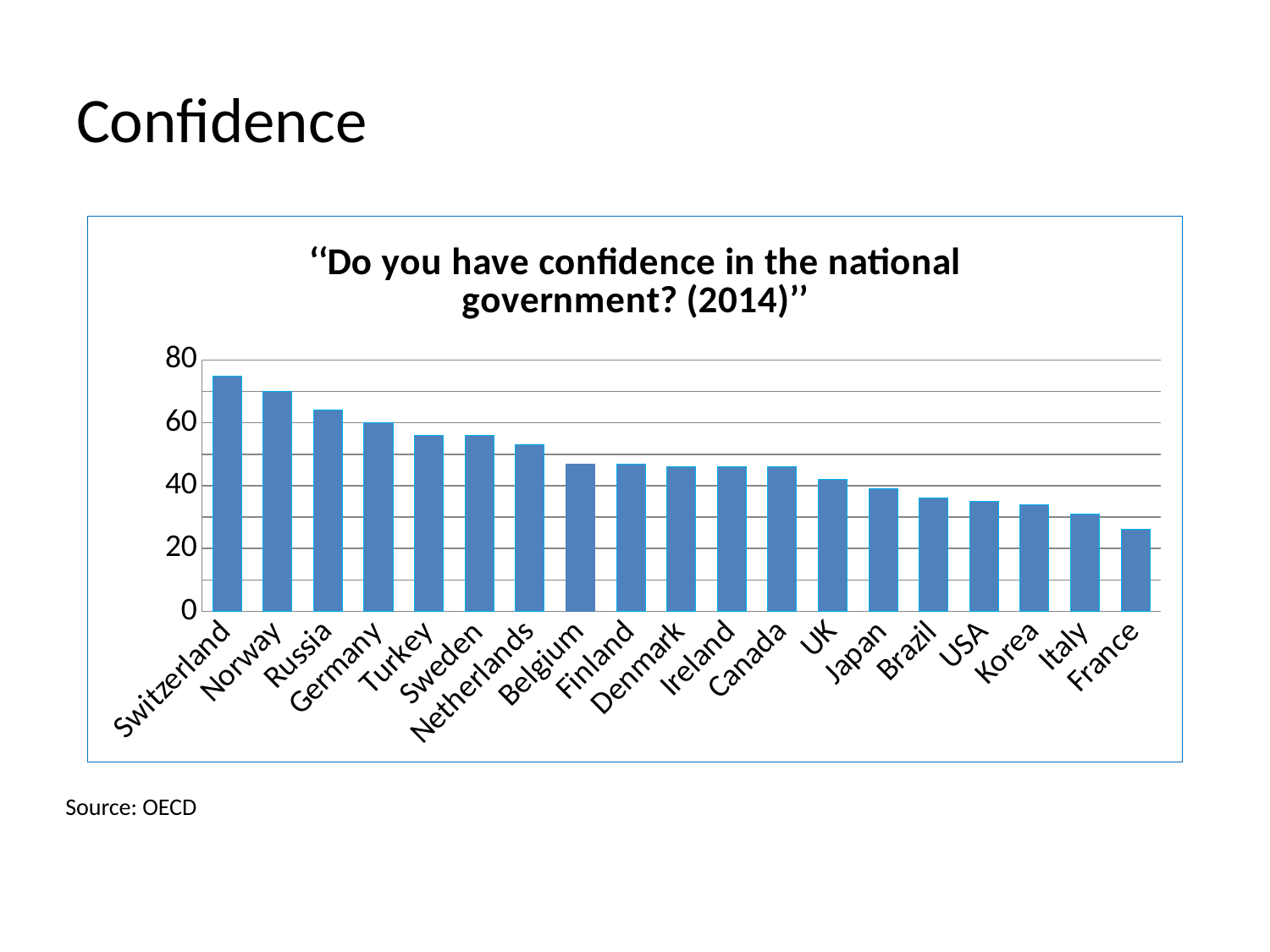
What is the title of the chart? “Do you have confidence in the national government? (2014)” What kind of chart is shown on the slide? bar chart Is the value for Switzerland greater or less than 60? greater Is the value for France greater or less than 40? less Which has a larger value, Italy or Netherlands? Netherlands Is the value for Norway greater or less than 60? greater How many countries are shown on the x axis of the chart? 19 Do the values rise or fall moving from left to right along the x axis? fall Which country has the highest value in the chart? Switzerland Which has a larger value, Russia or UK? Russia Which country has the lowest value in the chart? France